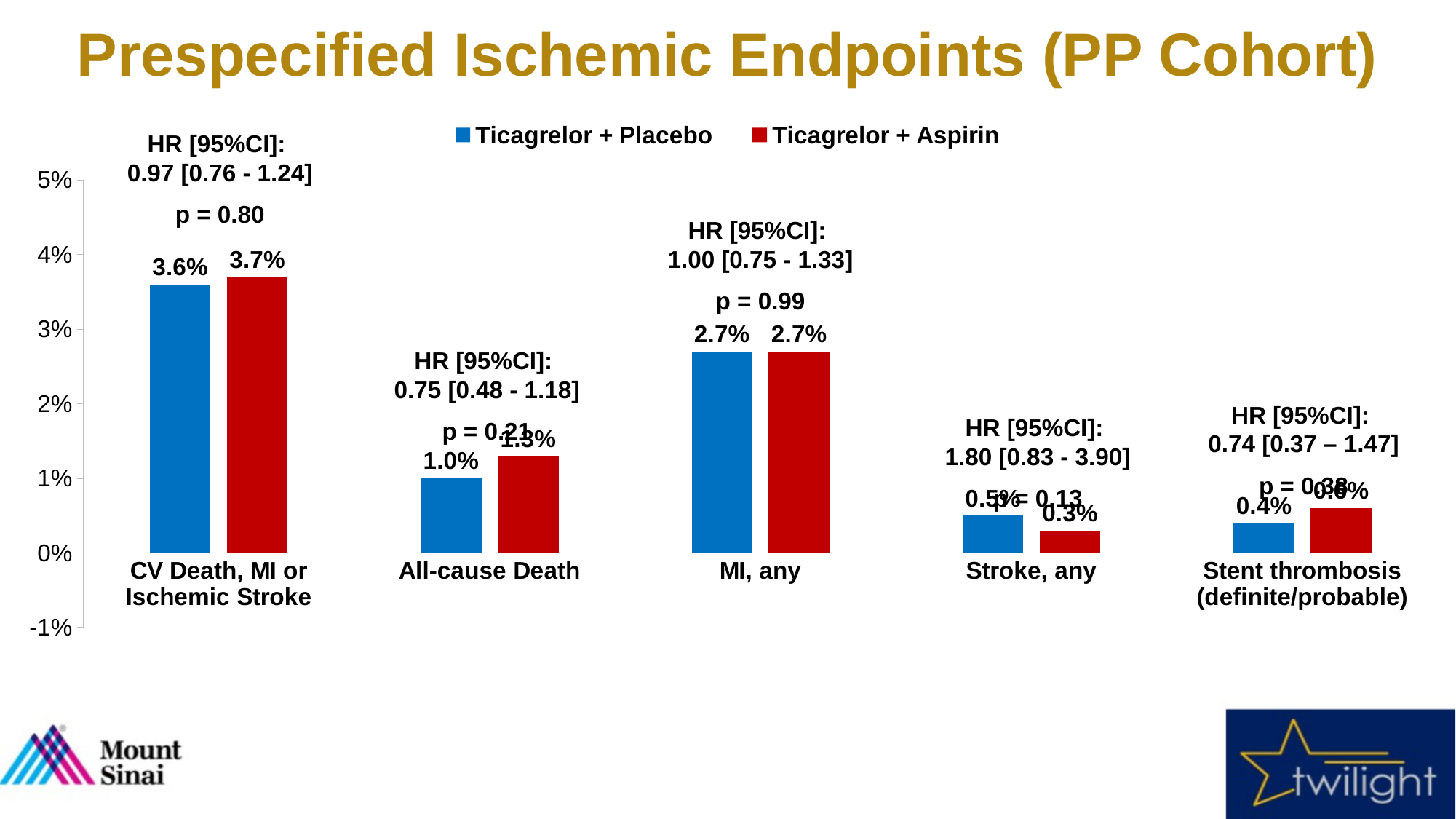
How many series does the legend list? 2 In the All-cause Death category, which series has the larger value? Ticagrelor + Aspirin What is the difference between the Ticagrelor + Aspirin and Ticagrelor + Placebo values in the CV Death, MI or Ischemic Stroke category? 0.1% Which series is shown in blue in the legend? Ticagrelor + Placebo Which category has the lowest value for Ticagrelor + Aspirin? Stroke, any Which category has the highest value for Ticagrelor + Placebo? CV Death, MI or Ischemic Stroke What kind of chart is shown on the slide? bar chart How many endpoint categories are shown on the x axis? 5 What is the value for Ticagrelor + Placebo in the All-cause Death category? 1.0% What is the value for Ticagrelor + Placebo in the MI, any category? 2.7% What is the value for Ticagrelor + Placebo in the CV Death, MI or Ischemic Stroke category? 3.6% What is the value for Ticagrelor + Aspirin in the CV Death, MI or Ischemic Stroke category? 3.7%